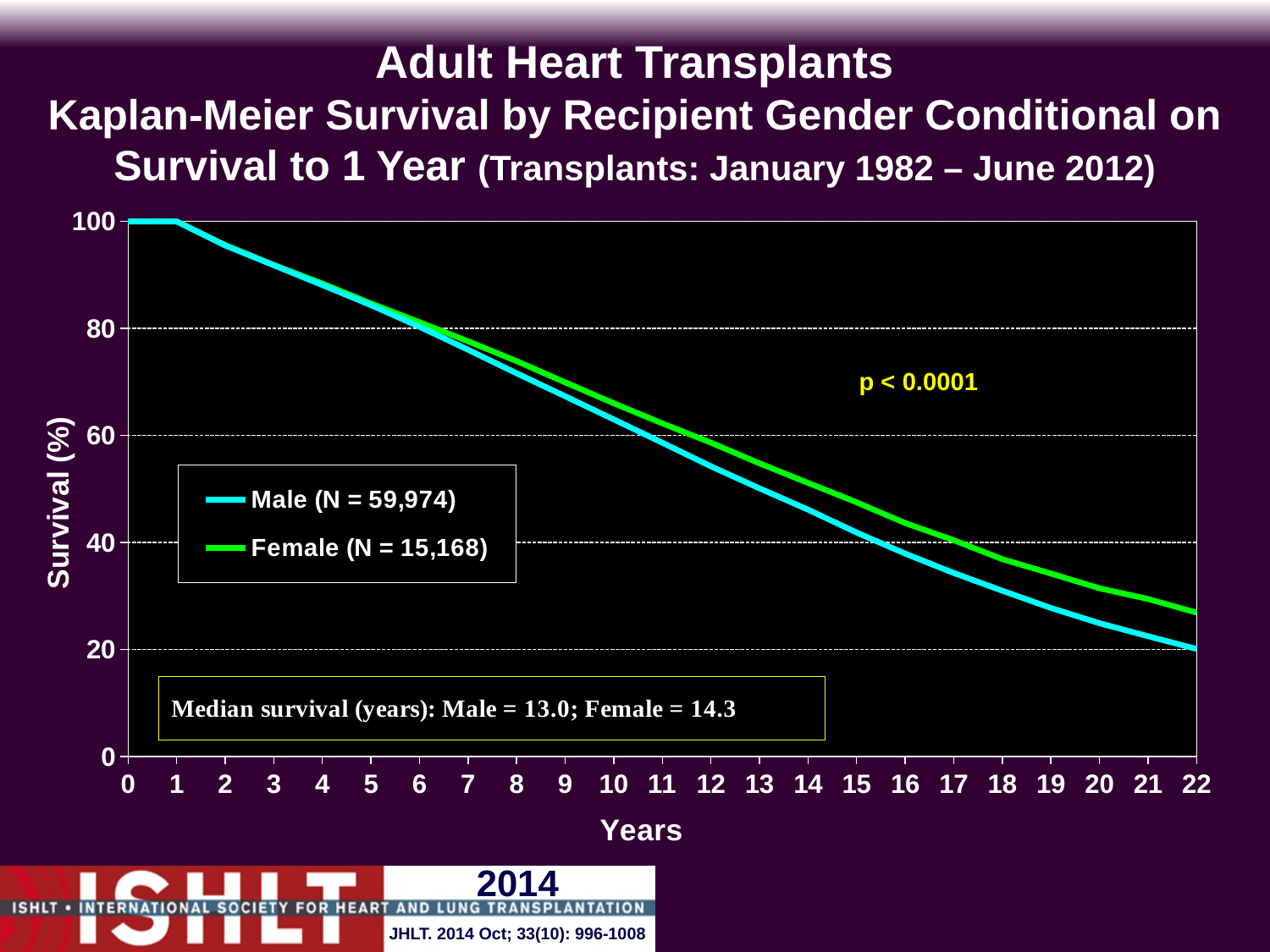
How many male recipients (N) are included in the chart? 59,974 What is the median survival in years for female recipients? 14.3 What is the difference in median survival (years) between female and male recipients? 1.3 How many female recipients (N) are included in the chart? 15,168 What kind of chart is shown on the slide? Line chart What p-value is shown on the chart? p < 0.0001 What is the median survival in years for male recipients? 13.0 Which recipient gender has the higher median survival? Female Do the survival curves rise or fall as years increase? Fall Is the survival value for male recipients at 18 years greater or less than 40? less How many series does the legend list? 2 Is the survival value for female recipients at 22 years greater or less than 20? greater